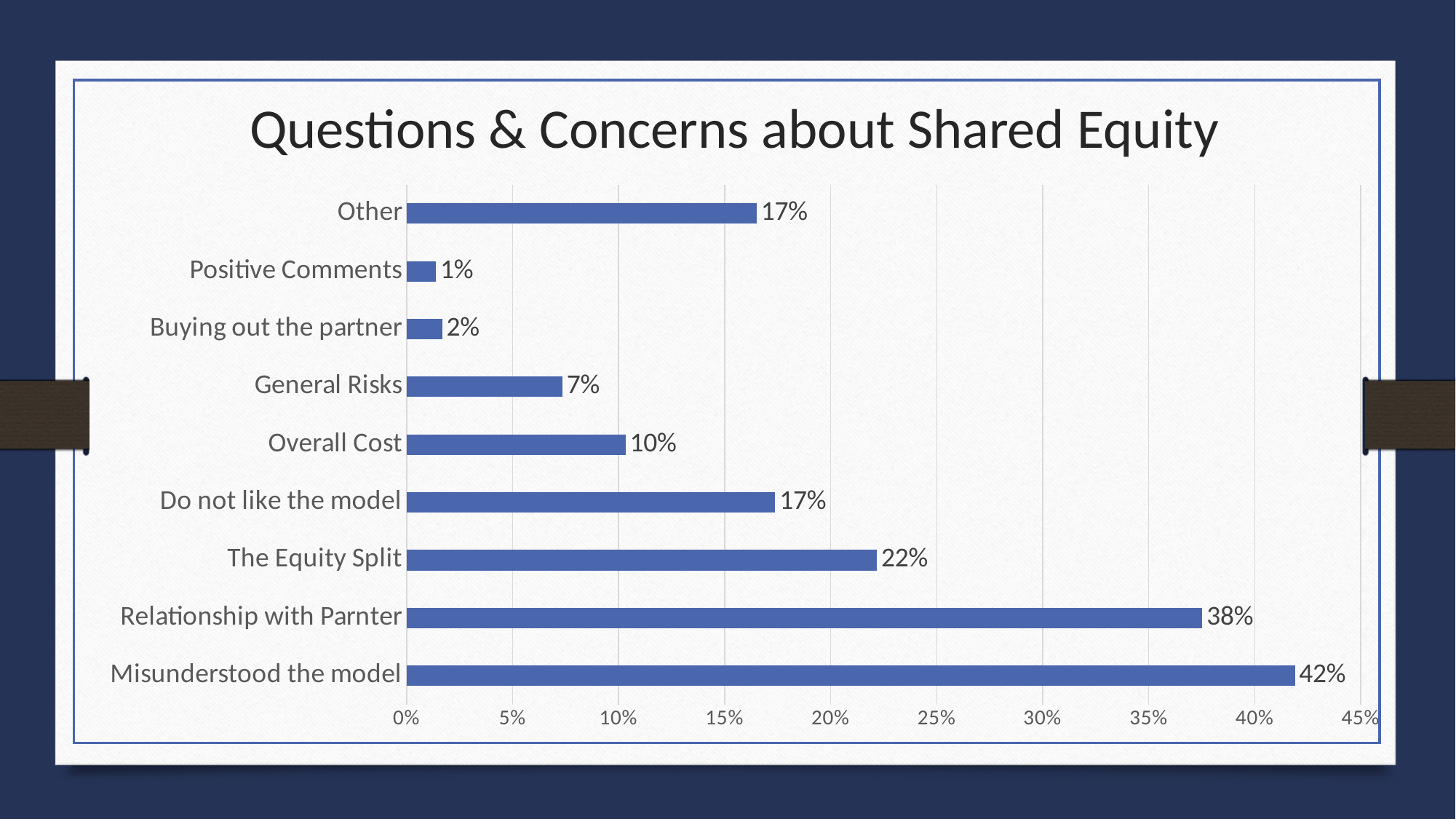
Which category has the lowest value? Positive Comments What is the title of the chart? Questions & Concerns about Shared Equity What is the value for Positive Comments? 1% What is the value for The Equity Split? 22% What is the value for Overall Cost? 10% Which is larger, The Equity Split or General Risks? The Equity Split What is the difference between Misunderstood the model and Relationship with Parnter? 4% What kind of chart is shown on the slide? Bar chart Which category has the highest value? Misunderstood the model What is the value for Misunderstood the model? 42% How many categories are shown in the chart? 9 What is the value for Relationship with Parnter? 38%